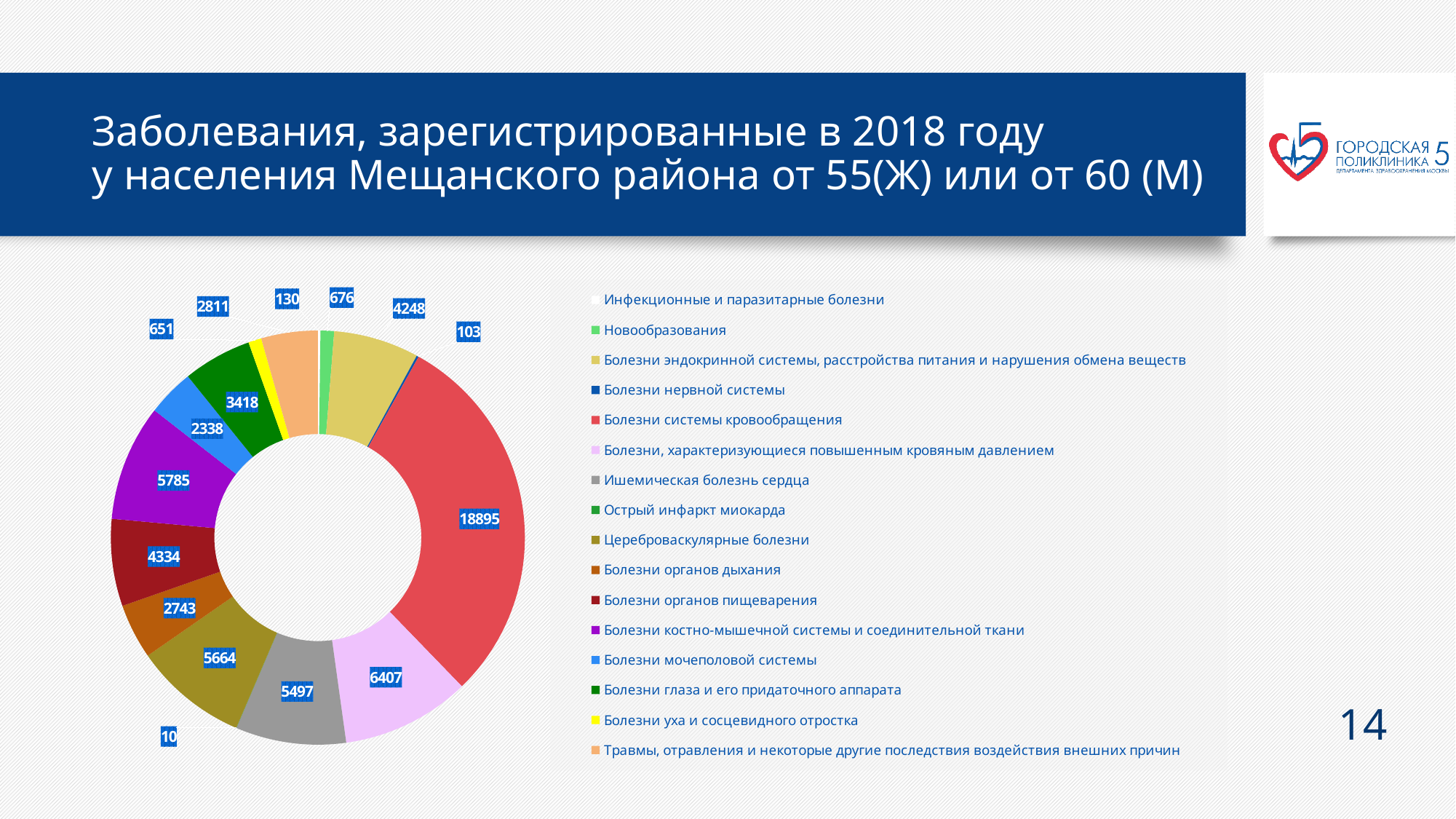
Which category has the highest value? Болезни системы кровообращения What type of chart is shown on the slide? Pie (doughnut) chart How many disease categories does the legend list? 16 What is the value for Болезни глаза и его придаточного аппарата? 3418 What is the value for Болезни костно-мышечной системы и соединительной ткани? 5785 What is the difference between the values for Болезни, характеризующиеся повышенным кровяным давлением and Ишемическая болезнь сердца? 910 What is the value for Новообразования? 676 Which category has the lowest value? Острый инфаркт миокарда Which is larger: the value for Болезни органов пищеварения or the value for Болезни органов дыхания? Болезни органов пищеварения What colour is the slice for Болезни системы кровообращения? Red What is the value for Болезни, характеризующиеся повышенным кровяным давлением? 6407 What is the value for Болезни системы кровообращения? 18895